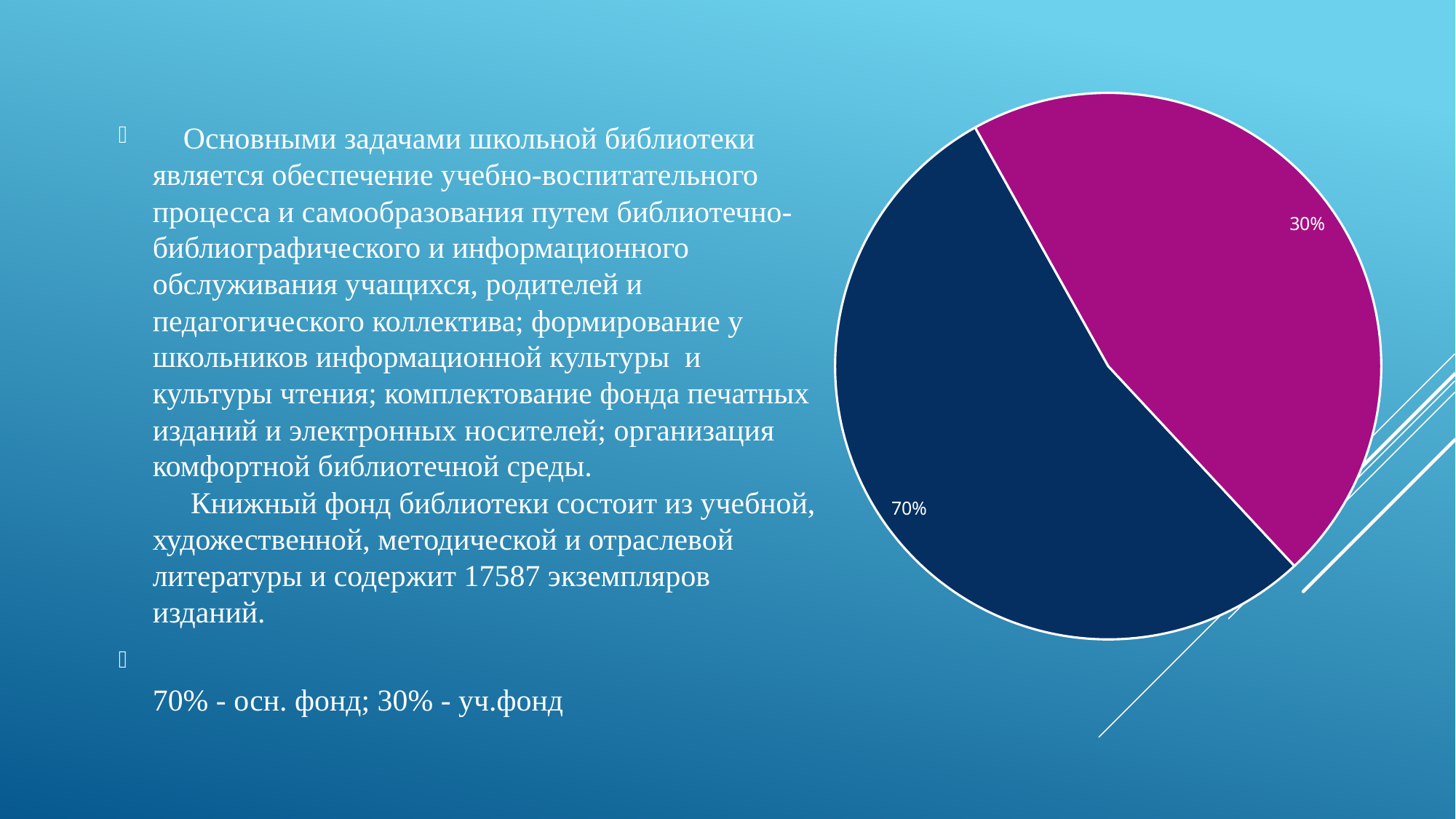
According to the slide text, what does the 30% slice of the pie chart represent? уч.фонд Which slice is the smallest in the pie chart, the dark blue one or the magenta one? the magenta one What share of the pie does the magenta slice take? 30% Which slice is the largest in the pie chart, the dark blue one or the magenta one? the dark blue one What percentage is shown on the larger slice of the pie chart? 70% What kind of chart is shown on the slide? pie chart What is the total of the two percentages shown on the pie chart? 100% What is the difference in percentage points between the two slices of the pie chart? 40 Is the 70% slice larger or smaller than the 30% slice? larger How many slices does the pie chart have? 2 According to the slide text, what does the 70% slice of the pie chart represent? осн. фонд What percentage is shown on the smaller slice of the pie chart? 30%